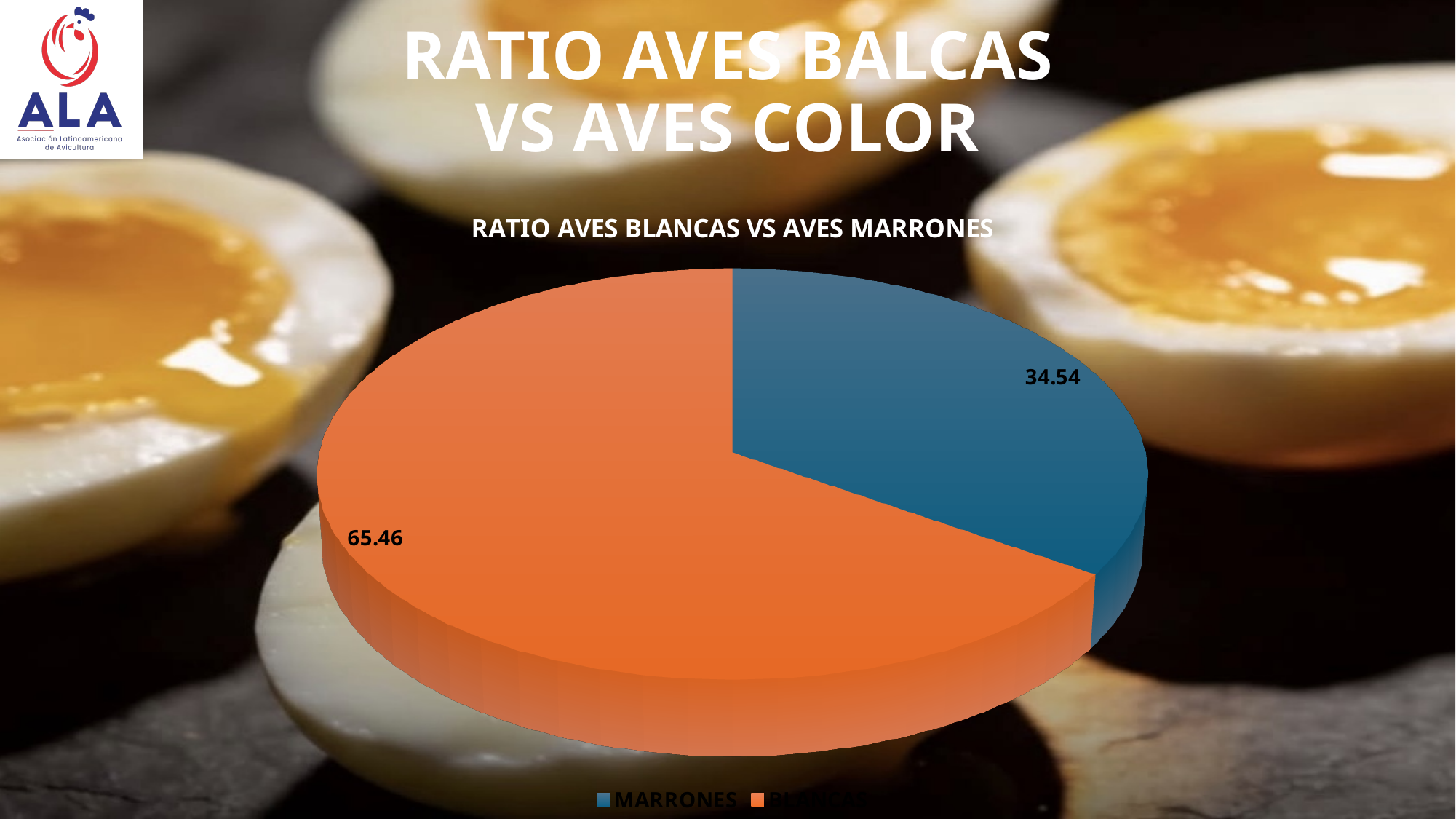
What is the difference between the BLANCAS and MARRONES values? 30.92 What kind of chart is shown on the slide? pie chart Which category has the smallest slice in the pie chart? MARRONES Which is larger, the value for BLANCAS or the value for MARRONES? BLANCAS What is the value for BLANCAS in the pie chart? 65.46 What is the value for MARRONES in the pie chart? 34.54 What colour is the MARRONES slice in the pie chart? blue What is the title of the chart? RATIO AVES BLANCAS VS AVES MARRONES What is the total of the two slice values in the pie chart? 100 Which category has the largest slice in the pie chart? BLANCAS How many slices does the pie chart have? 2 How many entries does the legend list? 2